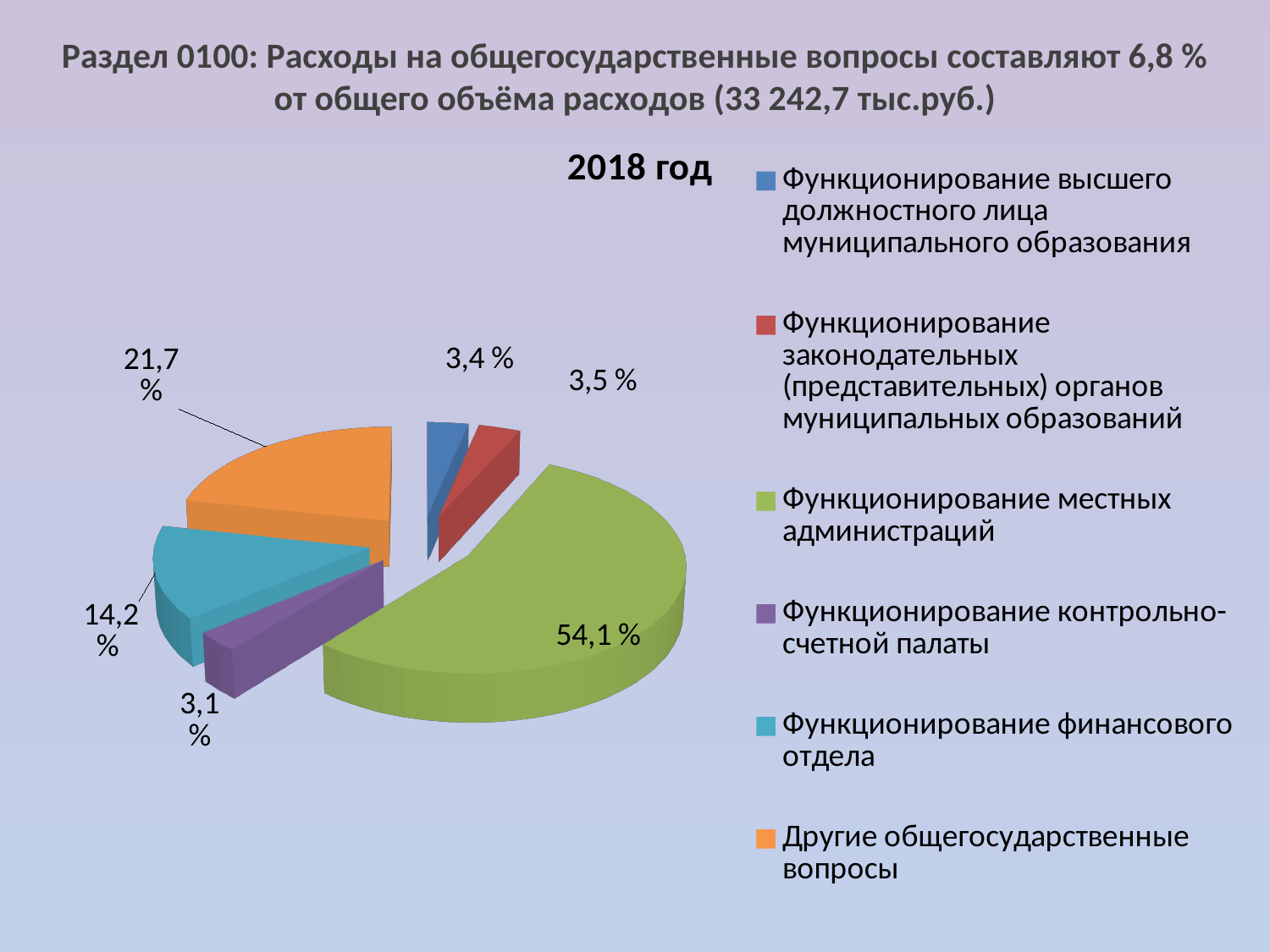
What kind of chart is shown on the slide? pie chart What is the share for Функционирование финансового отдела? 14,2 % What is the share for Функционирование местных администраций? 54,1 % What is the share for Функционирование контрольно-счетной палаты? 3,1 % Which category has the smallest slice of the pie? Функционирование контрольно-счетной палаты What is the share for Другие общегосударственные вопросы? 21,7 % How many categories does the legend list? 6 What is the share for Функционирование высшего должностного лица муниципального образования? 3,4 % What is the difference between the shares for Функционирование местных администраций and Другие общегосударственные вопросы? 32,4 % Which category has the largest slice of the pie? Функционирование местных администраций What is the title of the chart? 2018 год Which is larger: the share for Функционирование финансового отдела or for Другие общегосударственные вопросы? Другие общегосударственные вопросы